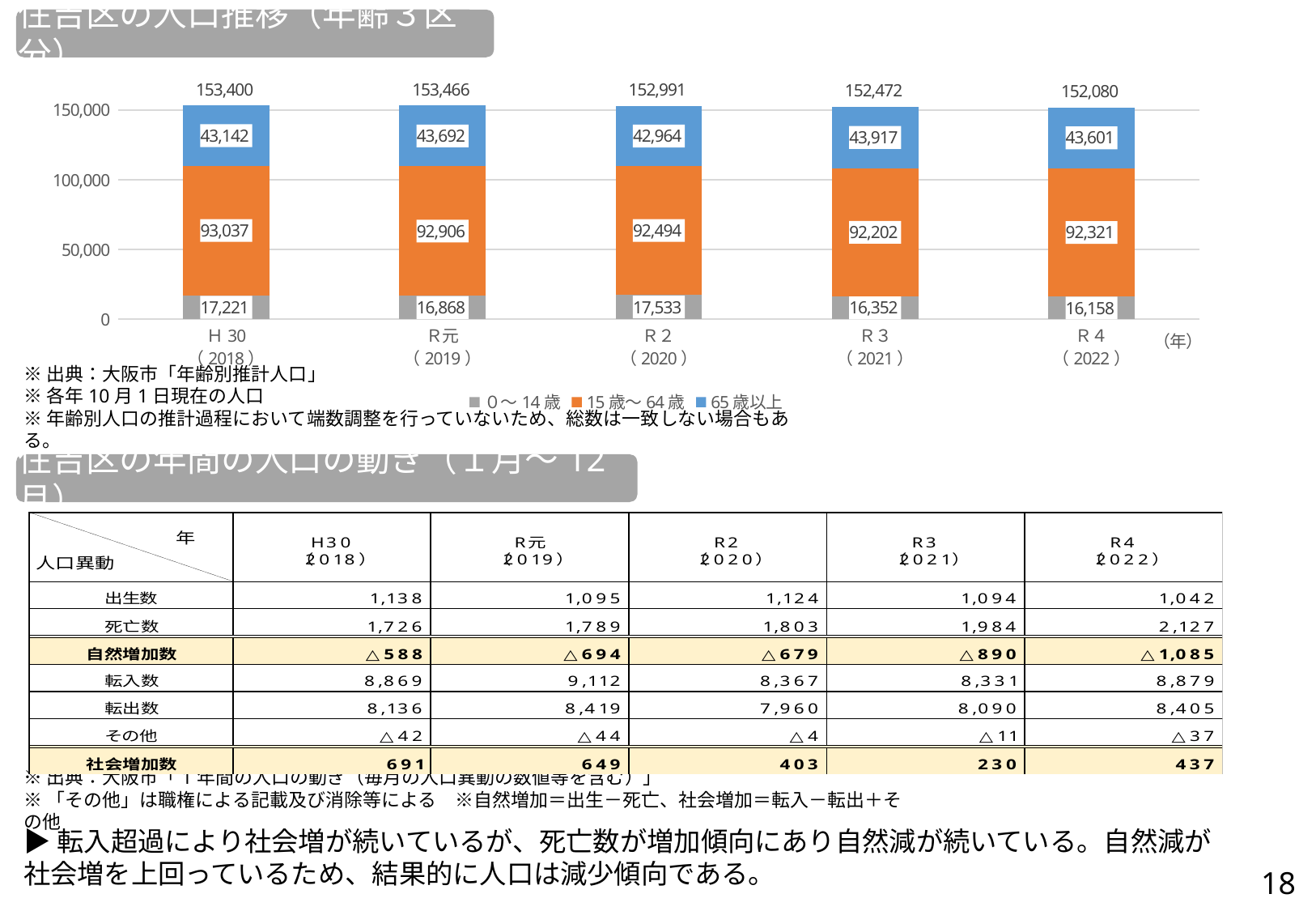
What is the value for 15歳〜64歳 in R2 (2020) on the population chart? 92,494 Which series is shown in orange on the population chart? 15歳〜64歳 What type of chart is shown at the top of the slide? stacked bar chart Which year has the highest total population on the population chart? R元 (2019) What is the total population shown above the bar for R元 (2019)? 153,466 How many years (categories) are plotted on the population chart? 5 Is the 15歳〜64歳 value larger in H30 (2018) or in R4 (2022)? H30 (2018) What is the difference between the 65歳以上 values for R3 (2021) and R2 (2020)? 953 What is the value for 0〜14歳 in H30 (2018) on the population chart? 17,221 How many series does the legend of the population chart list? 3 What is the value for 65歳以上 in R4 (2022) on the population chart? 43,601 Which year has the lowest value for 0〜14歳 on the population chart? R4 (2022)